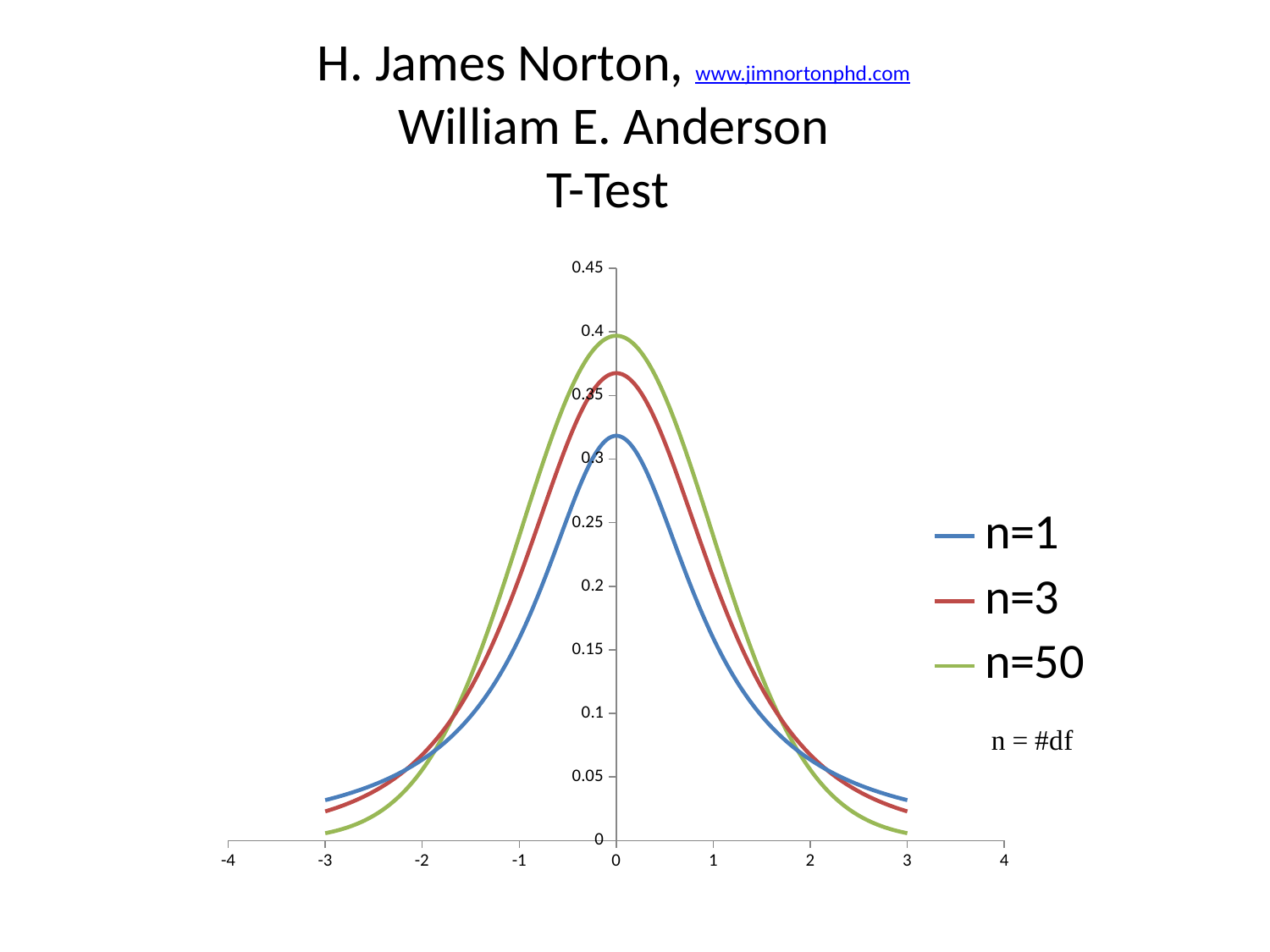
Do the curves rise or fall as x goes from 0 to 3? fall How many series does the legend list? 3 Is the value of the n=50 curve at x = 3 greater or less than 0.05? less Which series has the lowest peak at x = 0? n=1 What kind of chart is shown on the slide? line chart Is the peak value of the n=50 curve greater or less than 0.35? greater At x = 3, which curve has the larger value, n=1 or n=50? n=1 Which series reaches the highest peak at x = 0? n=50 Is the peak value of the n=3 curve greater or less than 0.3? greater What does the note below the legend say n stands for? n = #df At x = 0, which curve has the larger value, n=1 or n=3? n=3